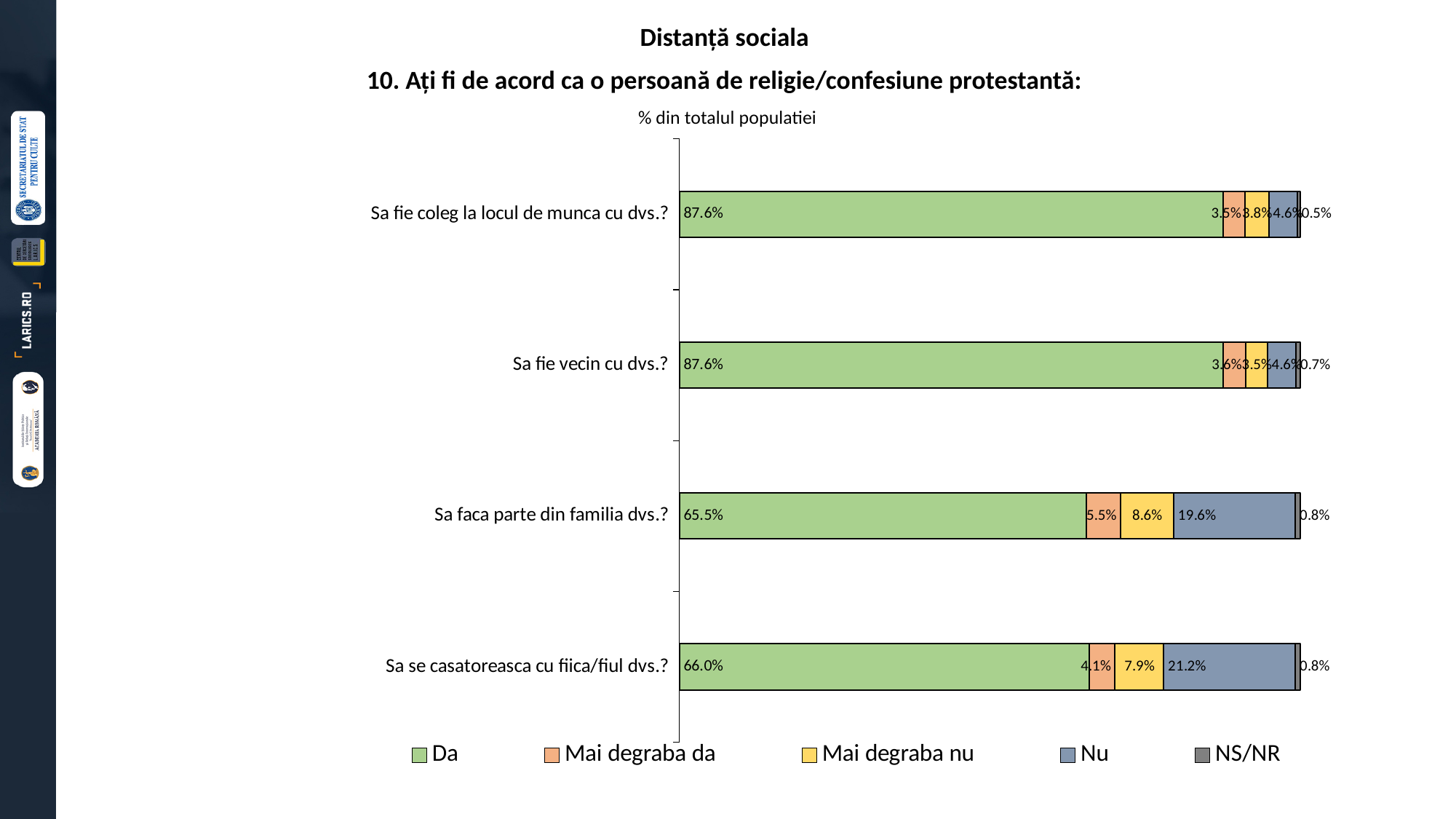
What is the 'Da' value for 'Sa se casatoreasca cu fiica/fiul dvs.?'? 66.0% What is the 'Nu' value for 'Sa faca parte din familia dvs.?'? 19.6% How many categories (questions) are plotted on the chart? 4 Which category has the lowest 'Da' value? Sa faca parte din familia dvs.? What type of chart is shown on the slide? stacked bar chart What is the difference between the 'Nu' values for 'Sa se casatoreasca cu fiica/fiul dvs.?' and 'Sa faca parte din familia dvs.?'? 1.6% How many series does the legend list? 5 Which category has the highest 'Nu' value? Sa se casatoreasca cu fiica/fiul dvs.? What is the 'Mai degraba nu' value for 'Sa se casatoreasca cu fiica/fiul dvs.?'? 7.9% Which is larger: the 'Mai degraba da' value for 'Sa faca parte din familia dvs.?' or for 'Sa se casatoreasca cu fiica/fiul dvs.?'? Sa faca parte din familia dvs.? What is the subtitle shown above the chart? % din totalul populatiei What is the 'Da' value for 'Sa fie vecin cu dvs.?'? 87.6%